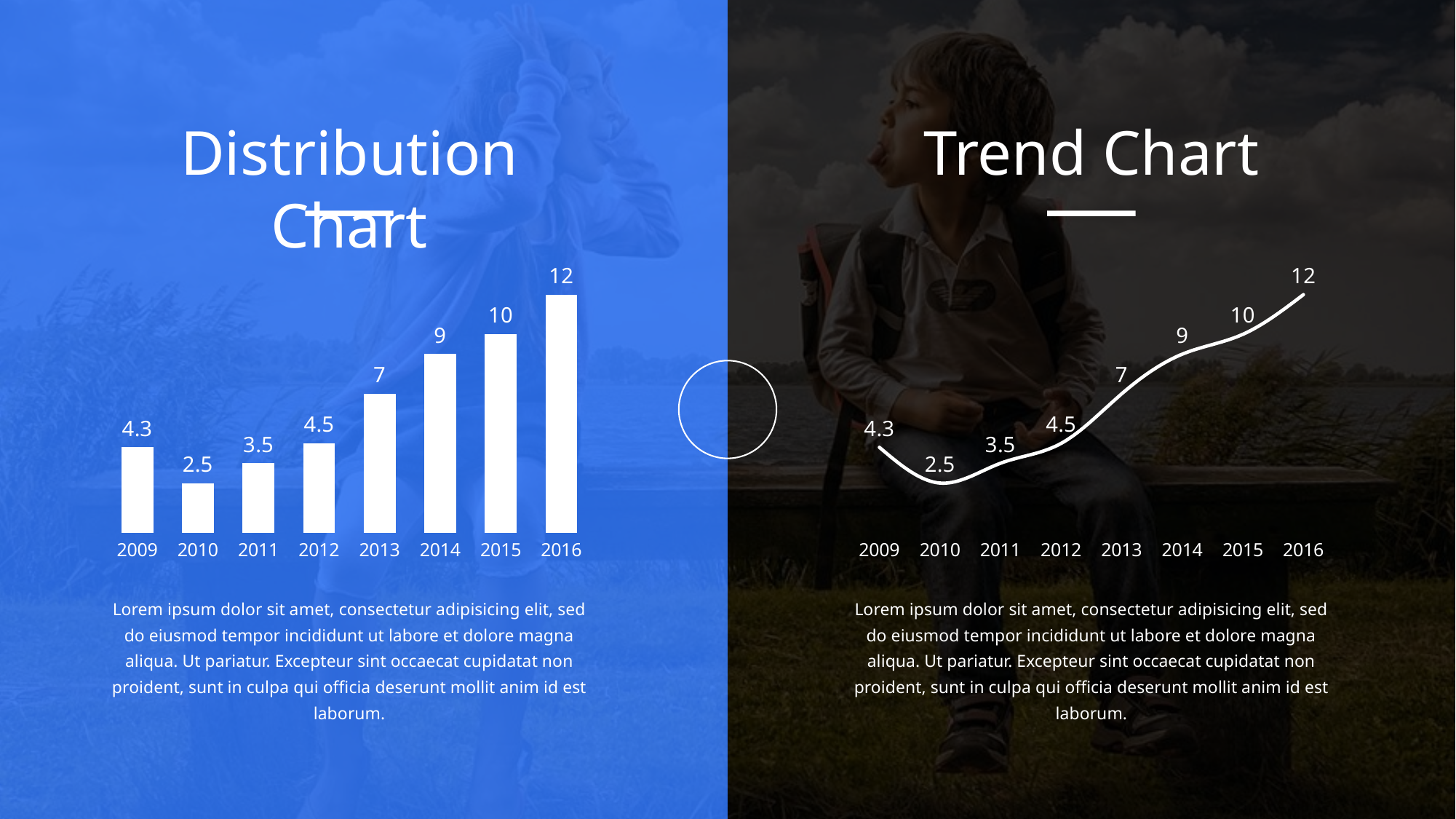
What is the title of the chart on the left side of the slide? Distribution Chart What kind of chart is the Trend Chart? line chart In the Trend Chart, what is the value for 2010? 2.5 In the Trend Chart, what is the difference between the values for 2015 and 2014? 1 In the Distribution Chart, which is larger, the value for 2009 or the value for 2011? 2009 In the Distribution Chart, what is the difference between the values for 2016 and 2009? 7.7 How many years are shown on the x axis of the Distribution Chart? 8 What kind of chart is the Distribution Chart? bar chart In the Distribution Chart, what is the value for 2013? 7 In the Distribution Chart, which year has the highest value? 2016 In the Trend Chart, which year has the lowest value? 2010 In the Trend Chart, do the values rise or fall from 2010 to 2016? rise